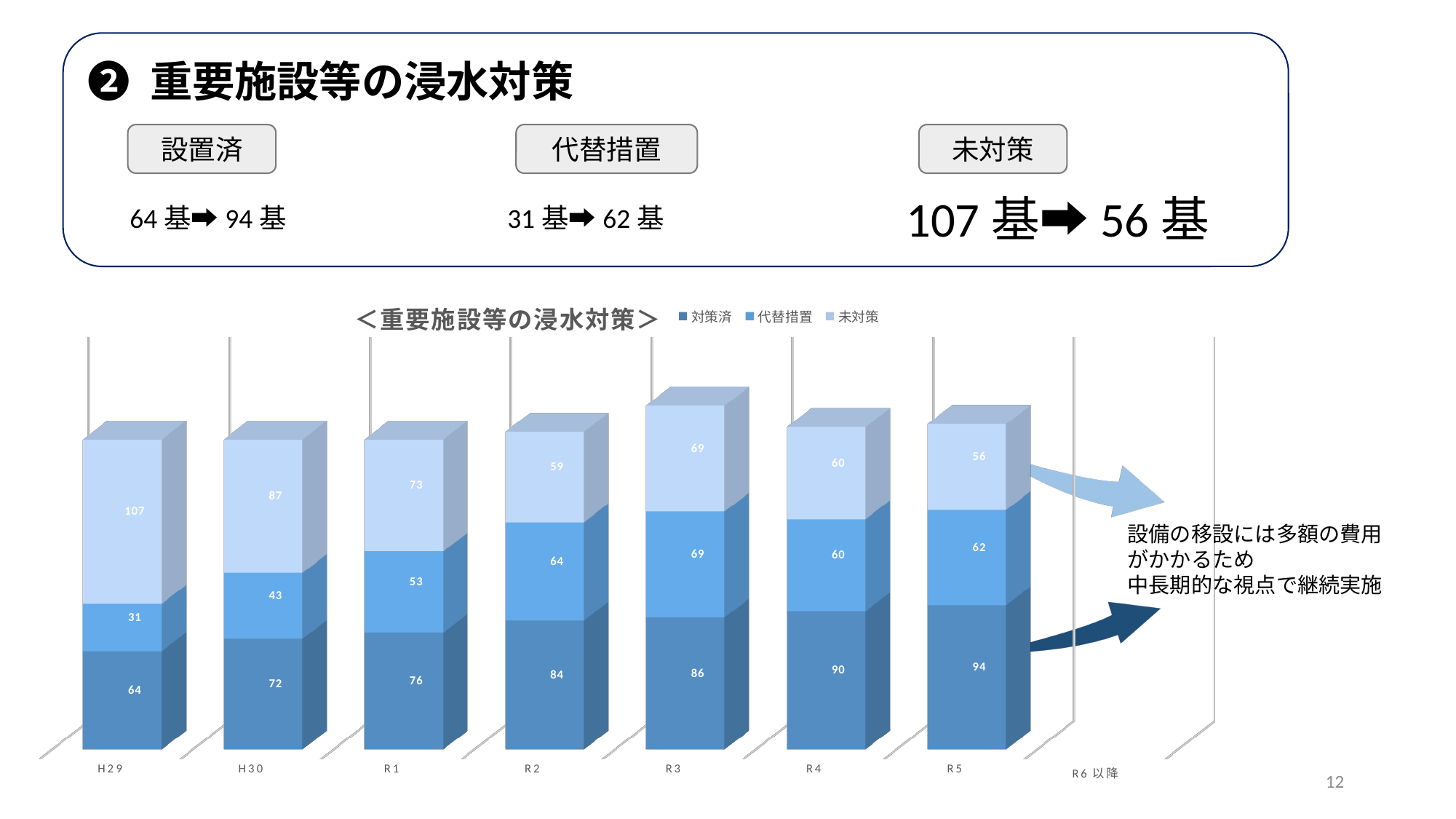
What is the difference between the 未対策 values for H29 and R5? 51 How do the 対策済 values change from H29 to R5? rise Which year has the lowest 未対策 value? R5 Which is larger, the 代替措置 value for R2 or for R4? R2 What is the total of the stacked bar for R5? 212 What is the 対策済 value for R5? 94 What is the 代替措置 value for R3? 69 What is the 未対策 value for H29? 107 How many stacked bars are plotted in the chart? 7 Which year has the highest 対策済 value? R5 How many series does the chart legend list? 3 What kind of chart is shown on the slide? stacked bar chart